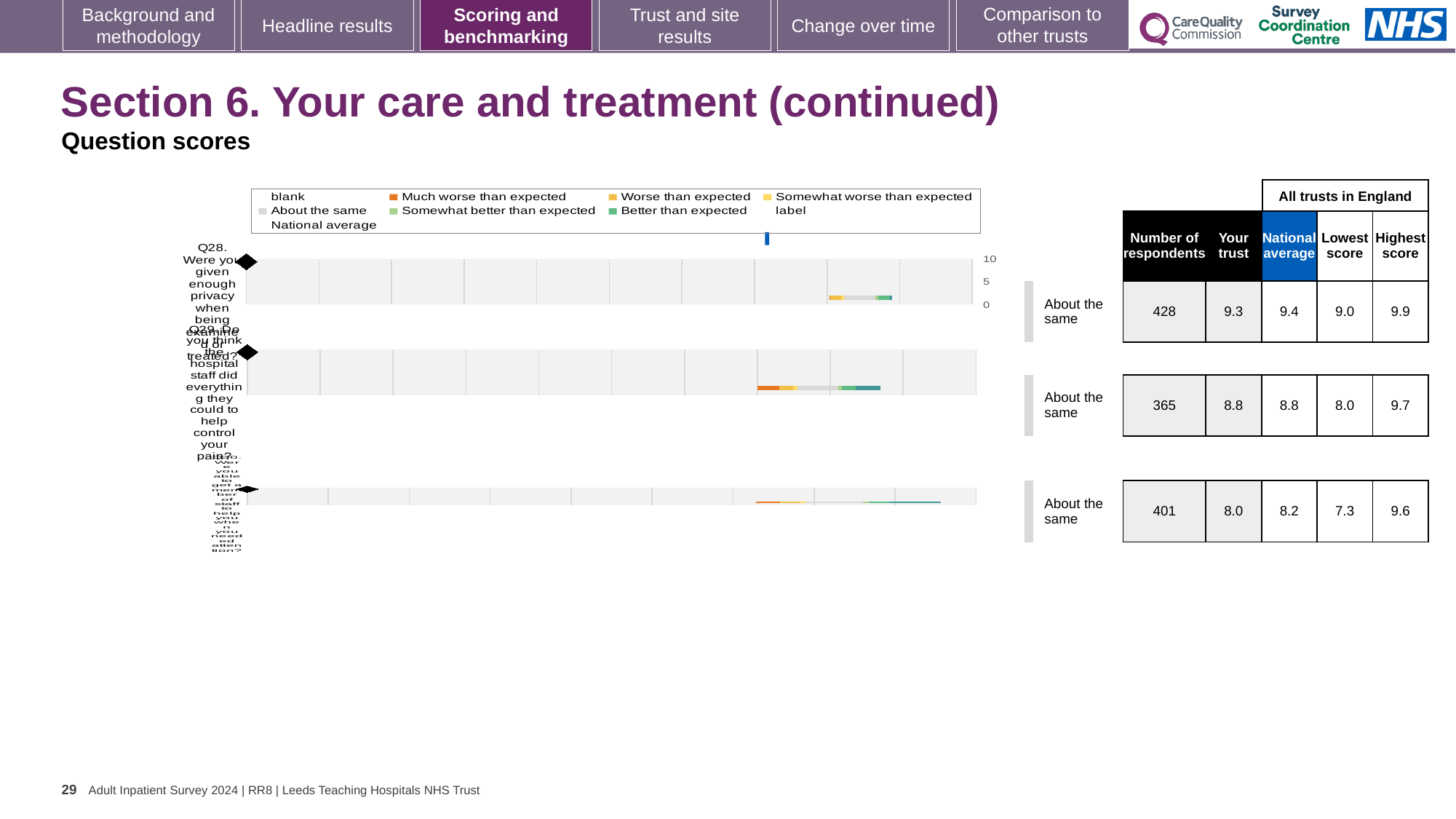
What is the 'Your trust' score for Q28 (Were you given enough privacy when being examined or treated?)? 9.3 What is the national average score for the third (bottom) question chart, Q30? 8.2 What is the 'Your trust' score for Q29 (Do you think the hospital staff did everything they could to help control your pain?)? 8.8 How many respondents answered Q28 (Were you given enough privacy when being examined or treated?)? 428 What is the national average score for Q28 (Were you given enough privacy when being examined or treated?)? 9.4 What is the 'Your trust' score for the third (bottom) question chart, Q30? 8.0 What type of chart is used to show the question scores? Bar chart Which of the three questions shown has the lowest 'Your trust' score? Q30 Which of the three questions shown has the highest 'Your trust' score? Q28 How many question charts are shown on the slide? 3 Which is larger: the 'Your trust' score for Q28 or for Q29? Q28 What is the difference between the national average and the 'Your trust' score for Q28? 0.1